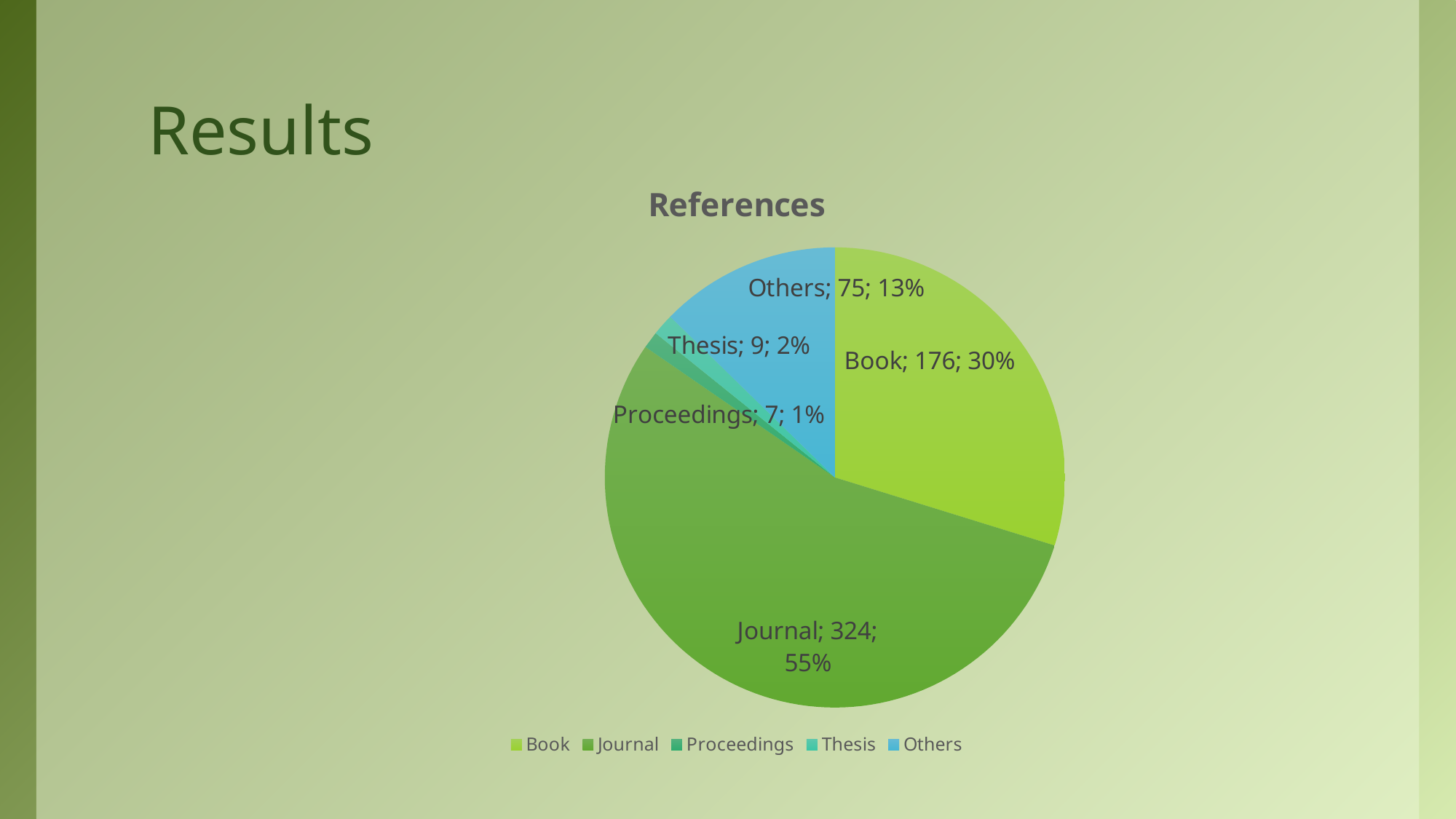
What is the value for Journal? 324 What type of chart is shown on the slide? Pie chart What share of the pie does Thesis represent? 2% What is the value for Book? 176 Which category has the smallest slice? Proceedings What is the value for Others? 75 What is the title of the chart? References What is the difference between the values for Journal and Book? 148 Which is larger, the value for Others or the value for Thesis? Others What share of the pie does Journal represent? 55% Which category has the largest slice? Journal How many categories does the pie chart have? 5